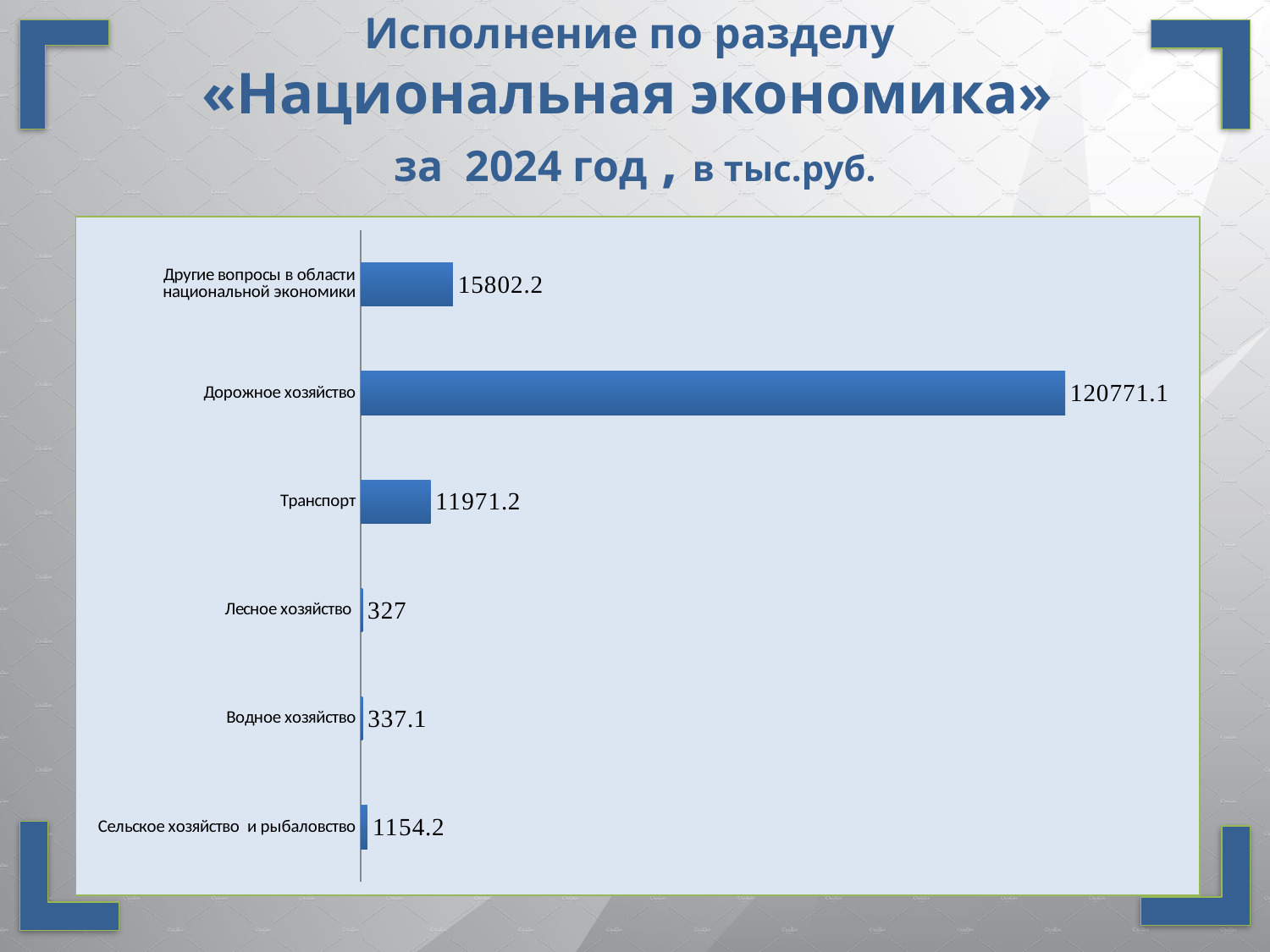
What is the difference between the values for Водное хозяйство and Лесное хозяйство? 10.1 Which category has the lowest value? Лесное хозяйство What is the value for Транспорт? 11971.2 What is the value for Другие вопросы в области национальной экономики? 15802.2 Which is larger, the value for Сельское хозяйство и рыбаловство or the value for Водное хозяйство? Сельское хозяйство и рыбаловство What is the value for Сельское хозяйство и рыбаловство? 1154.2 How many categories are shown in the chart? 6 Which category has the highest value? Дорожное хозяйство What is the value for Лесное хозяйство? 327 What is the value for Дорожное хозяйство? 120771.1 What is the difference between the values for Другие вопросы в области национальной экономики and Транспорт? 3831 What kind of chart is shown on the slide? Bar chart